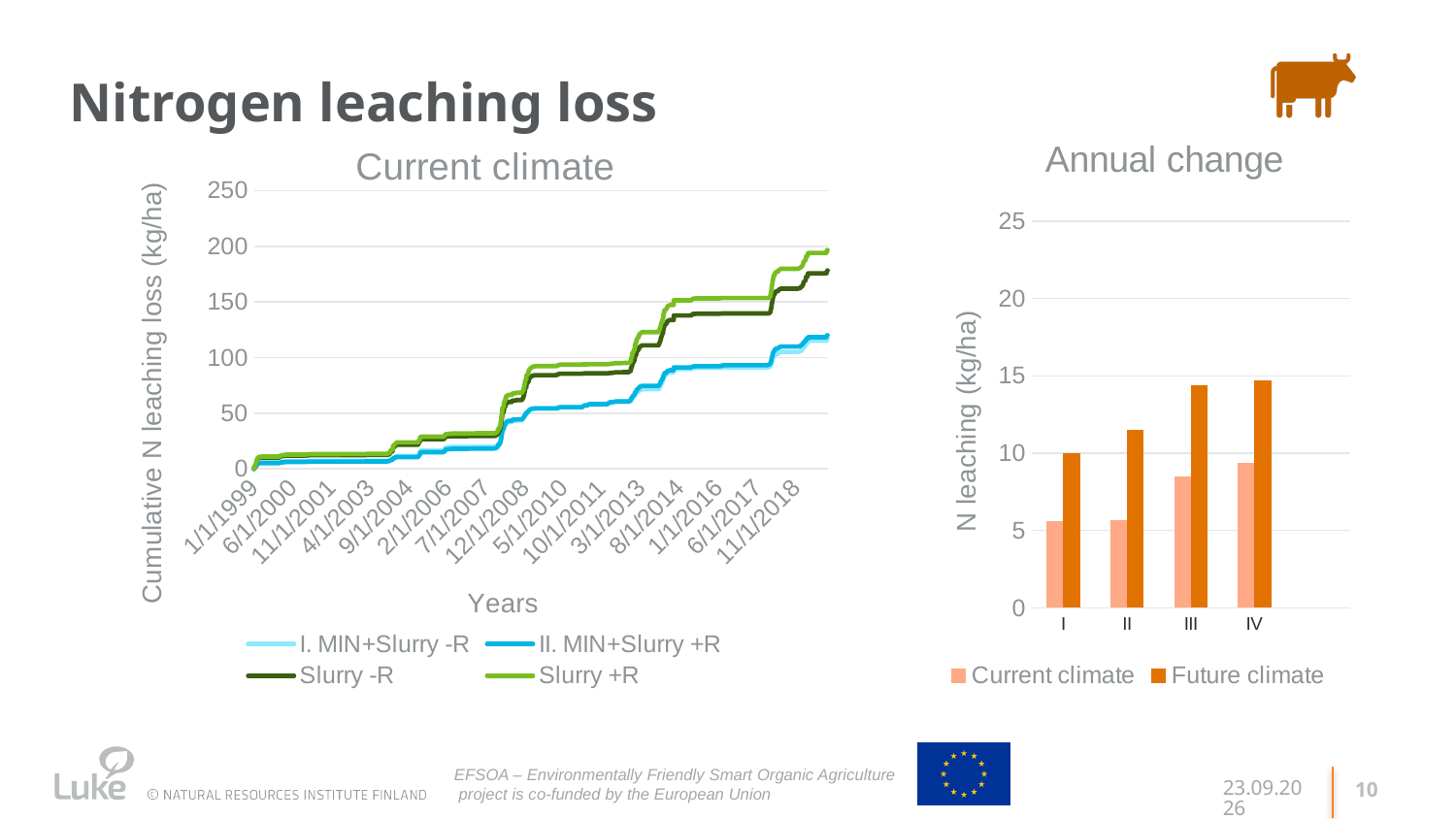
What is the y-axis title of the "Current climate" chart? Cumulative N leaching loss (kg/ha) What kind of chart is the "Annual change" chart? bar chart What kind of chart is the "Current climate" chart? line chart How many series does the legend of the "Annual change" chart list? 2 In the "Annual change" chart, is the Future climate value for III greater or less than 10? greater In the "Current climate" chart, which series reaches the highest value at the end of the period? Slurry +R In the "Current climate" chart, is the final value of Slurry +R greater or less than 150? greater In the "Current climate" chart, do the lines rise or fall over the years? rise How many series does the legend of the "Current climate" chart list? 4 How many categories are shown on the x axis of the "Annual change" chart? 4 In the "Annual change" chart, is the Current climate value for IV greater or less than 10? less In the "Annual change" chart, which is larger for category II: Current climate or Future climate? Future climate